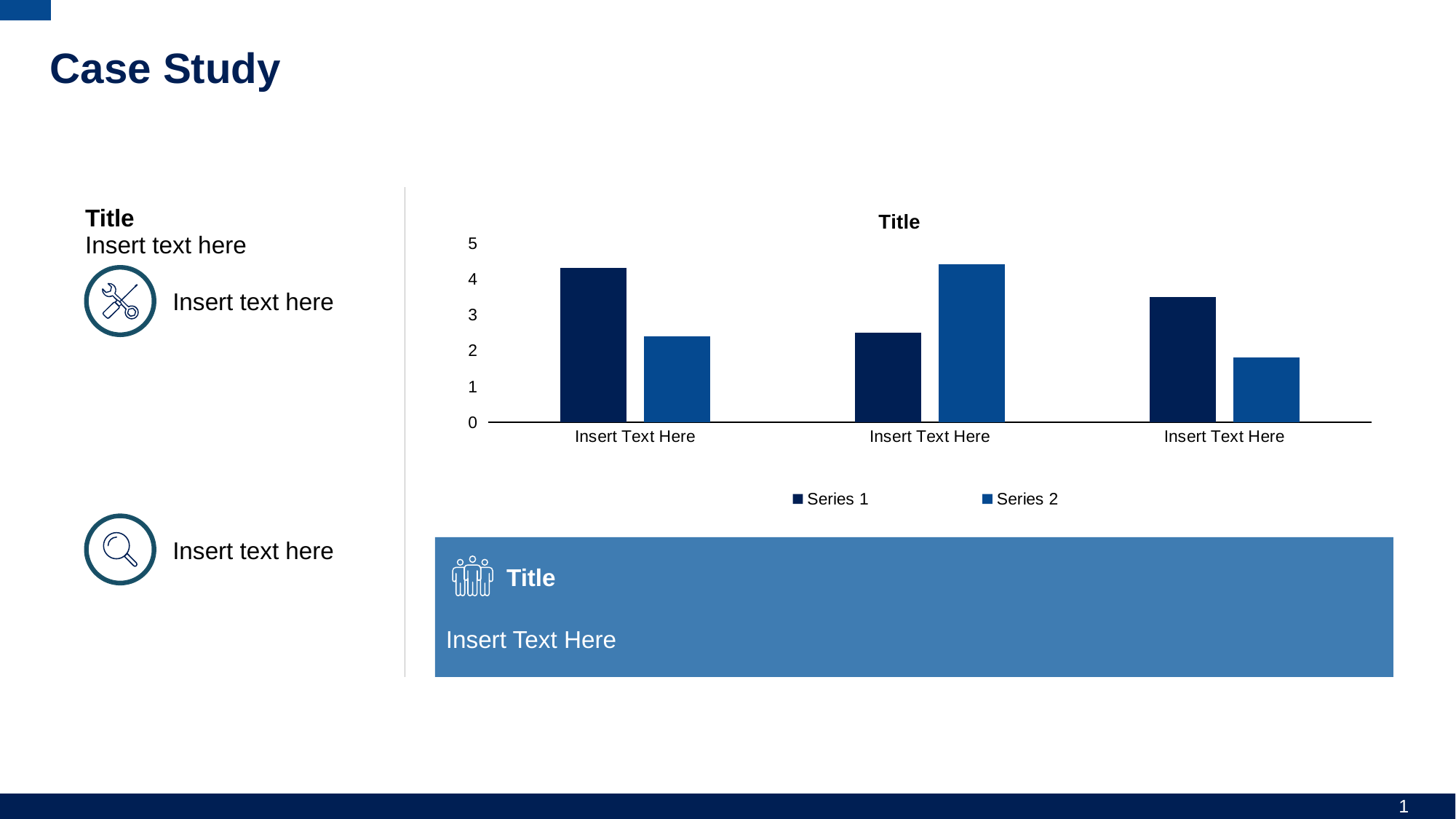
Is the Series 2 value for the first (leftmost) category greater or less than 3? less For which category (by position) is the Series 2 bar the shortest? the third (rightmost) category For which category (by position) is the Series 1 bar the tallest? the first (leftmost) category In the second (middle) category, which series has the larger value, Series 1 or Series 2? Series 2 Is the Series 2 value for the third (rightmost) category greater or less than 2? less How many series does the chart's legend list? 2 What is the title of the chart? Title How many categories are shown along the x axis of the chart? 3 What are the two entries in the chart's legend? Series 1 and Series 2 What kind of chart is shown on the slide? bar chart Is the Series 1 value for the first (leftmost) category greater or less than 4? greater